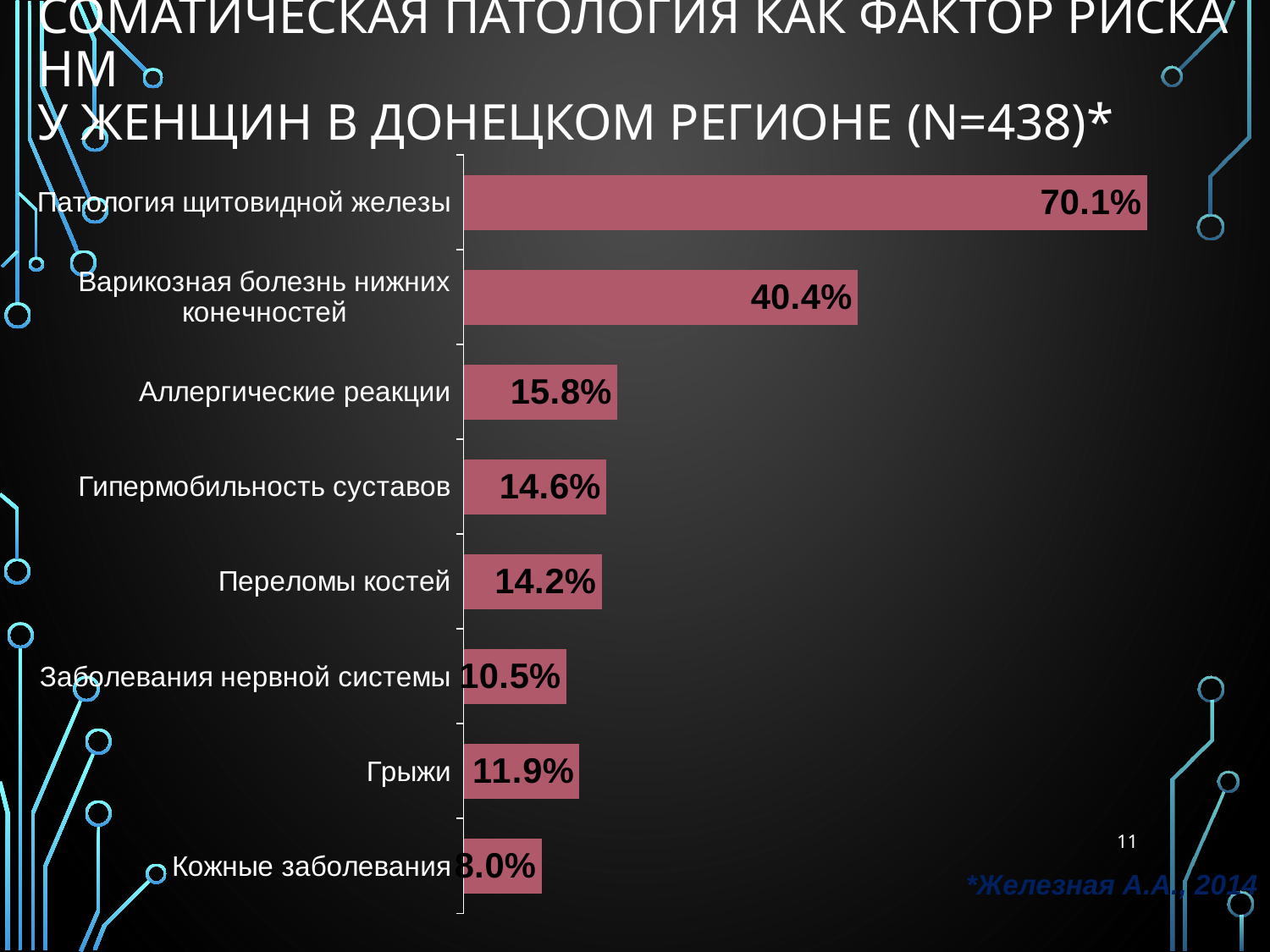
What is the value for Грыжи? 11.9% Which category has the highest value? Патология щитовидной железы What is the difference between the values for Патология щитовидной железы and Варикозная болезнь нижних конечностей? 29.7% What is the difference between the values for Аллергические реакции and Гипермобильность суставов? 1.2% What is the value for Кожные заболевания? 8.0% What is the value for Переломы костей? 14.2% What is the value for Патология щитовидной железы? 70.1% How many categories are shown in the chart? 8 What is the value for Варикозная болезнь нижних конечностей? 40.4% What kind of chart is shown on the slide? Bar chart Which category has the lowest value? Кожные заболевания Which is larger, the value for Грыжи or the value for Заболевания нервной системы? Грыжи